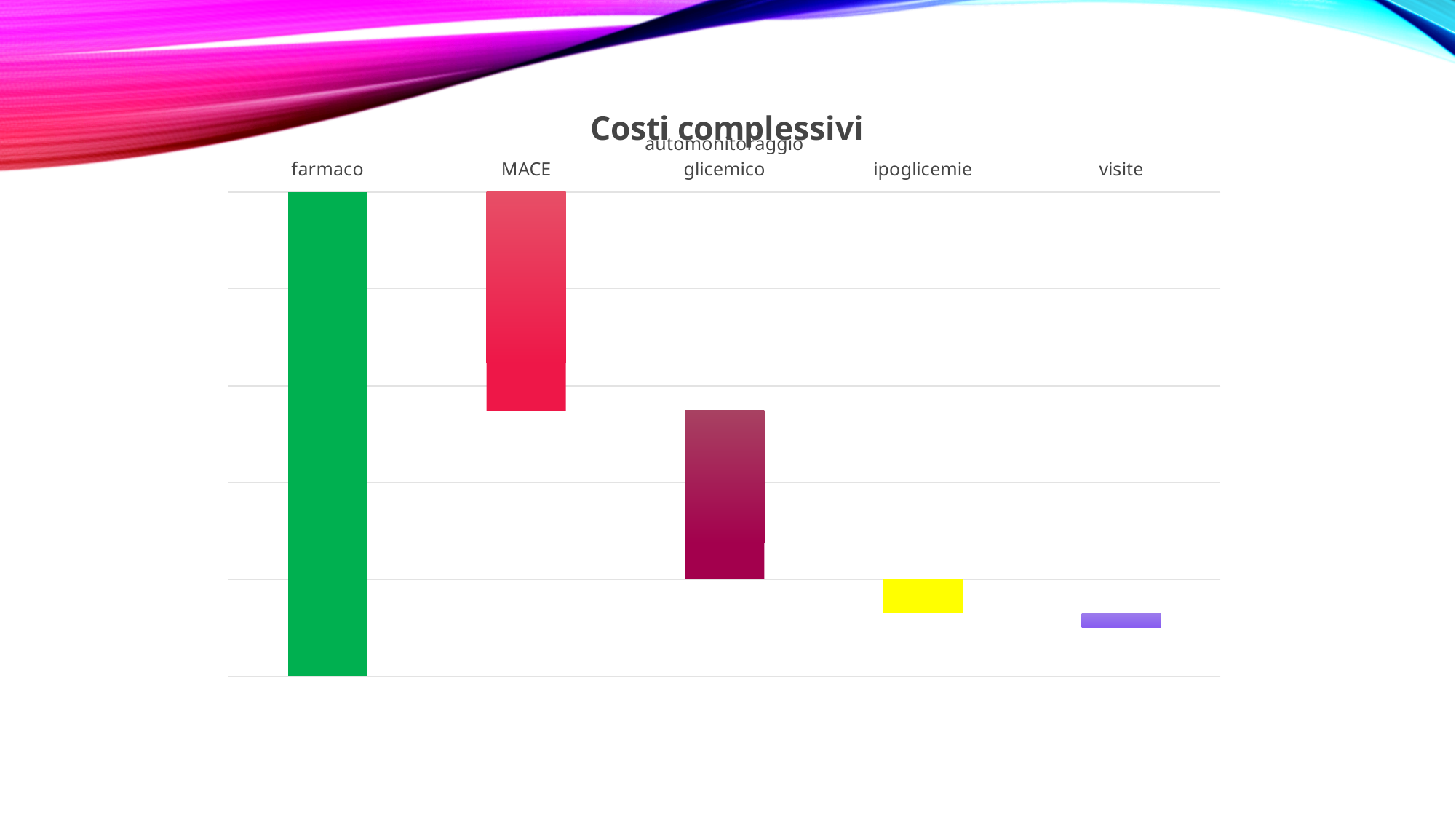
Which bar is longer, MACE or ipoglicemie? MACE Which bar is longer, farmaco or MACE? farmaco What kind of chart is shown on the slide? bar chart How many categories are shown on the x axis of the chart? 5 Which category is the second from the left on the x axis? MACE What is the title of the chart? Costi complessivi Do the bar lengths rise or fall from left to right across the categories? fall Which category has the shortest bar in the chart? visite Which bar is longer, automonitoraggio glicemico or visite? automonitoraggio glicemico What colour is the bar for farmaco? green Which category is shown with a yellow bar? ipoglicemie Which category has the longest bar in the chart? farmaco